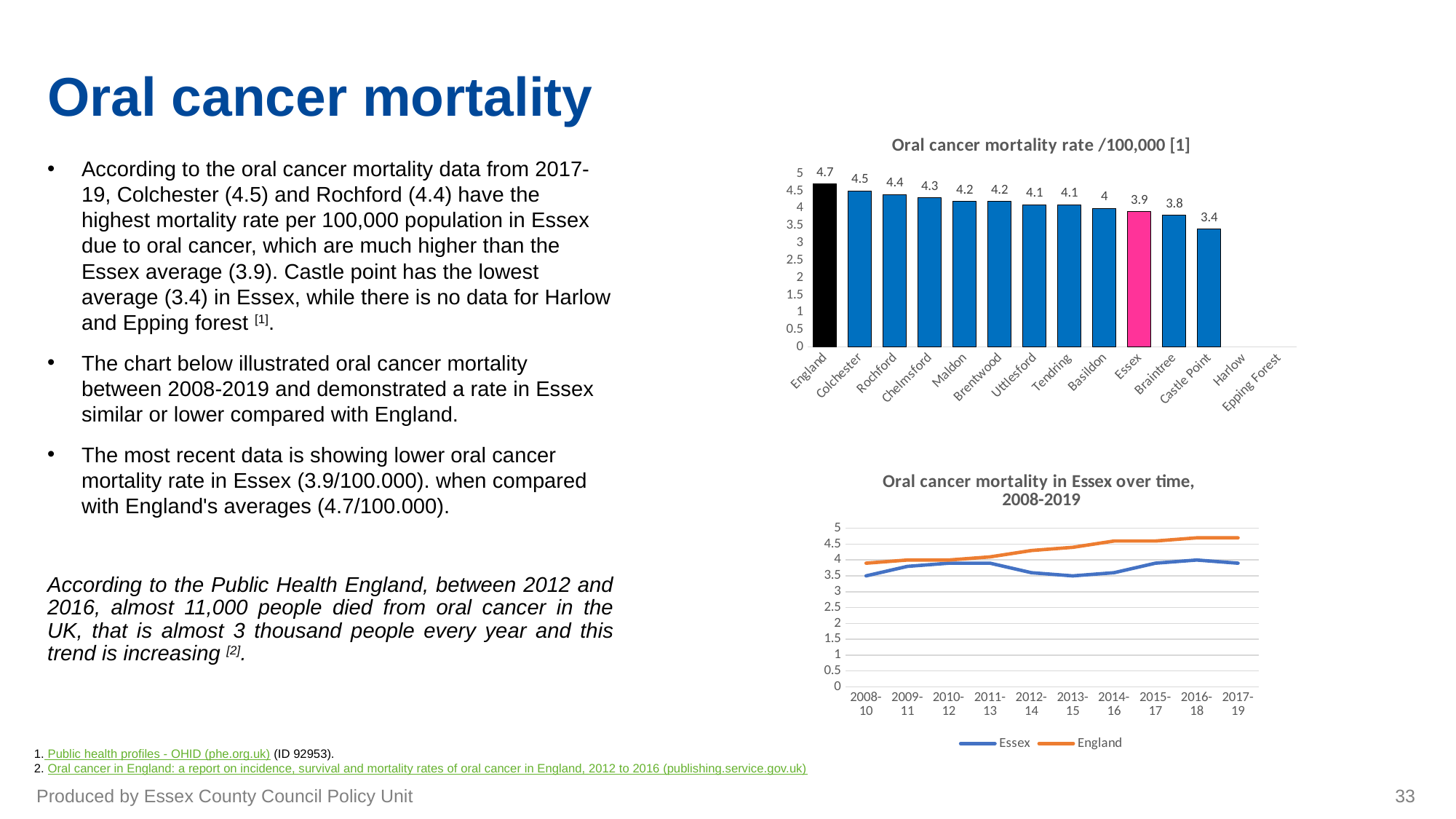
In the chart titled 'Oral cancer mortality rate /100,000 [1]', which is larger, the value for Rochford or the value for Braintree? Rochford In the chart titled 'Oral cancer mortality rate /100,000 [1]', what is the difference between the values for England and Essex? 0.8 In the chart titled 'Oral cancer mortality rate /100,000 [1]', which category has the highest value? England In the chart titled 'Oral cancer mortality rate /100,000 [1]', what is the value for Essex? 3.9 In the chart titled 'Oral cancer mortality in Essex over time, 2008-2019', does the England series generally rise or fall from 2008-10 to 2017-19? Rise In the chart titled 'Oral cancer mortality rate /100,000 [1]', what kind of chart is it? Bar chart In the chart titled 'Oral cancer mortality in Essex over time, 2008-2019', is the England value for 2017-19 greater or less than 4.5? greater In the chart titled 'Oral cancer mortality rate /100,000 [1]', what is the value for Colchester? 4.5 In the chart titled 'Oral cancer mortality rate /100,000 [1]', what is the value for Basildon? 4 In the chart titled 'Oral cancer mortality rate /100,000 [1]', which category with a plotted bar has the lowest value? Castle Point In the chart titled 'Oral cancer mortality in Essex over time, 2008-2019', how many series does the legend list? 2 In the chart titled 'Oral cancer mortality in Essex over time, 2008-2019', how many time periods are shown on the x axis? 10